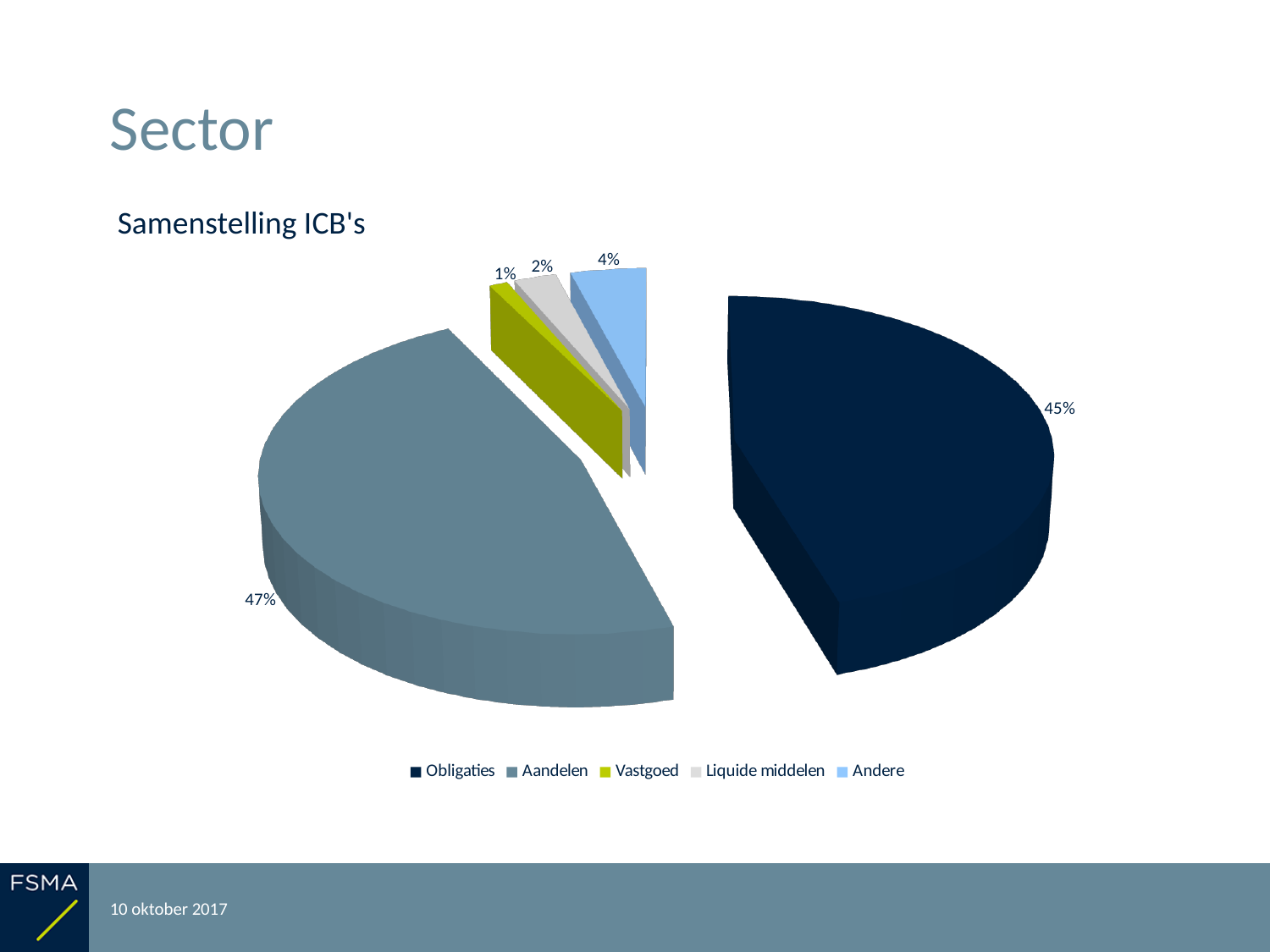
What share of the pie does Liquide middelen represent? 2% Which is larger, the share for Andere or the share for Liquide middelen? Andere What share of the pie does Andere represent? 4% What share of the pie does Aandelen represent? 47% What is the difference in percentage points between Aandelen and Obligaties? 2 What is the title of the chart? Samenstelling ICB's Which category has the smallest share of the pie? Vastgoed How many categories does the legend list? 5 Which category has the largest share of the pie? Aandelen What kind of chart is shown on the slide? pie chart